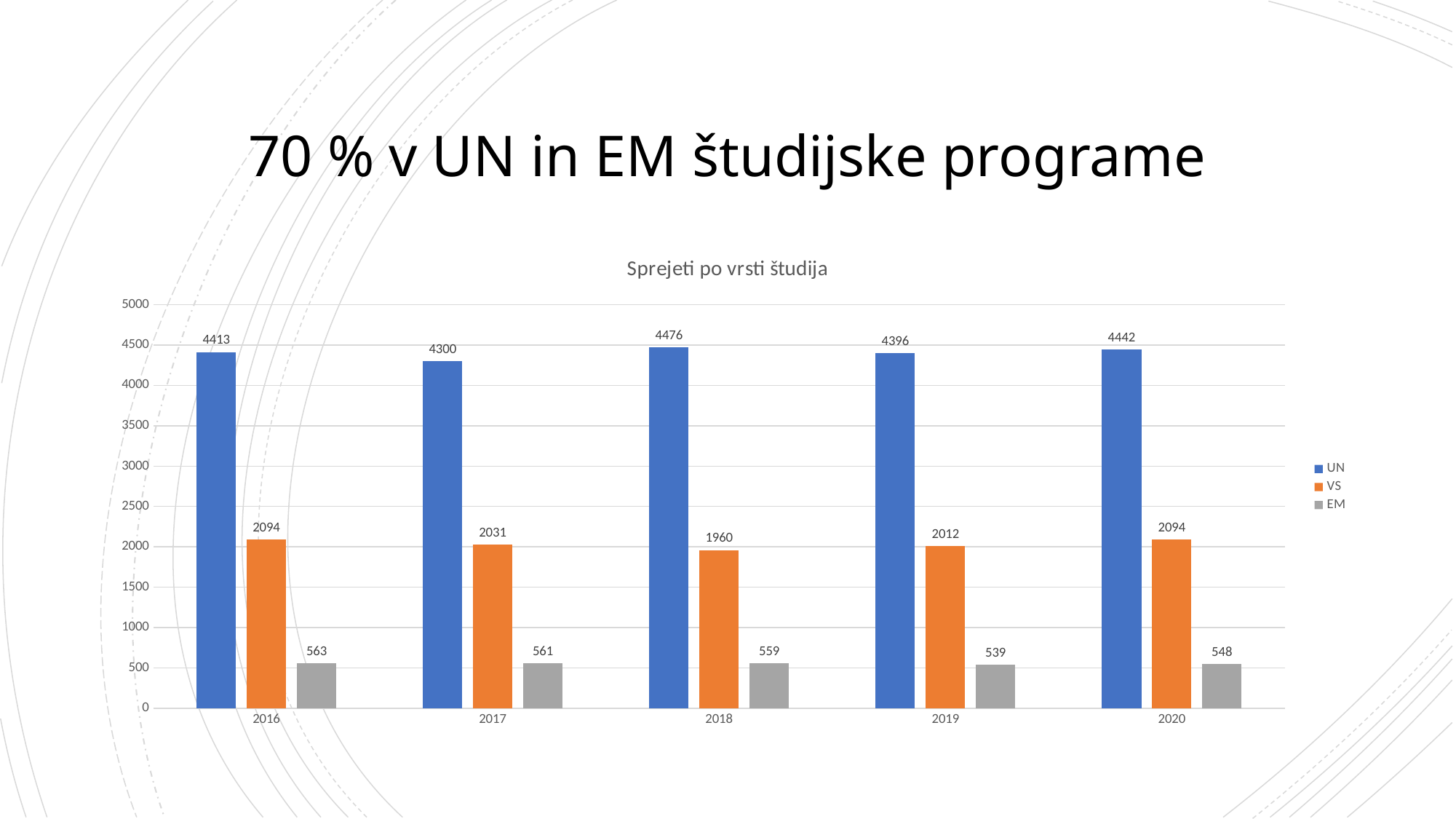
Which is larger, the EM value in 2016 or the EM value in 2020? 2016 Is the value for VS in 2016 greater or less than 2000? greater What kind of chart is shown? bar chart How many years are shown on the x axis? 5 What is the difference between the UN value in 2018 and the UN value in 2017? 176 In which year is the UN value highest? 2018 What is the title of the chart? Sprejeti po vrsti študija What is the value for VS in 2017? 2031 What is the value for EM in 2019? 539 What is the value for UN in 2018? 4476 How many series does the legend list? 3 In which year is the VS value lowest? 2018